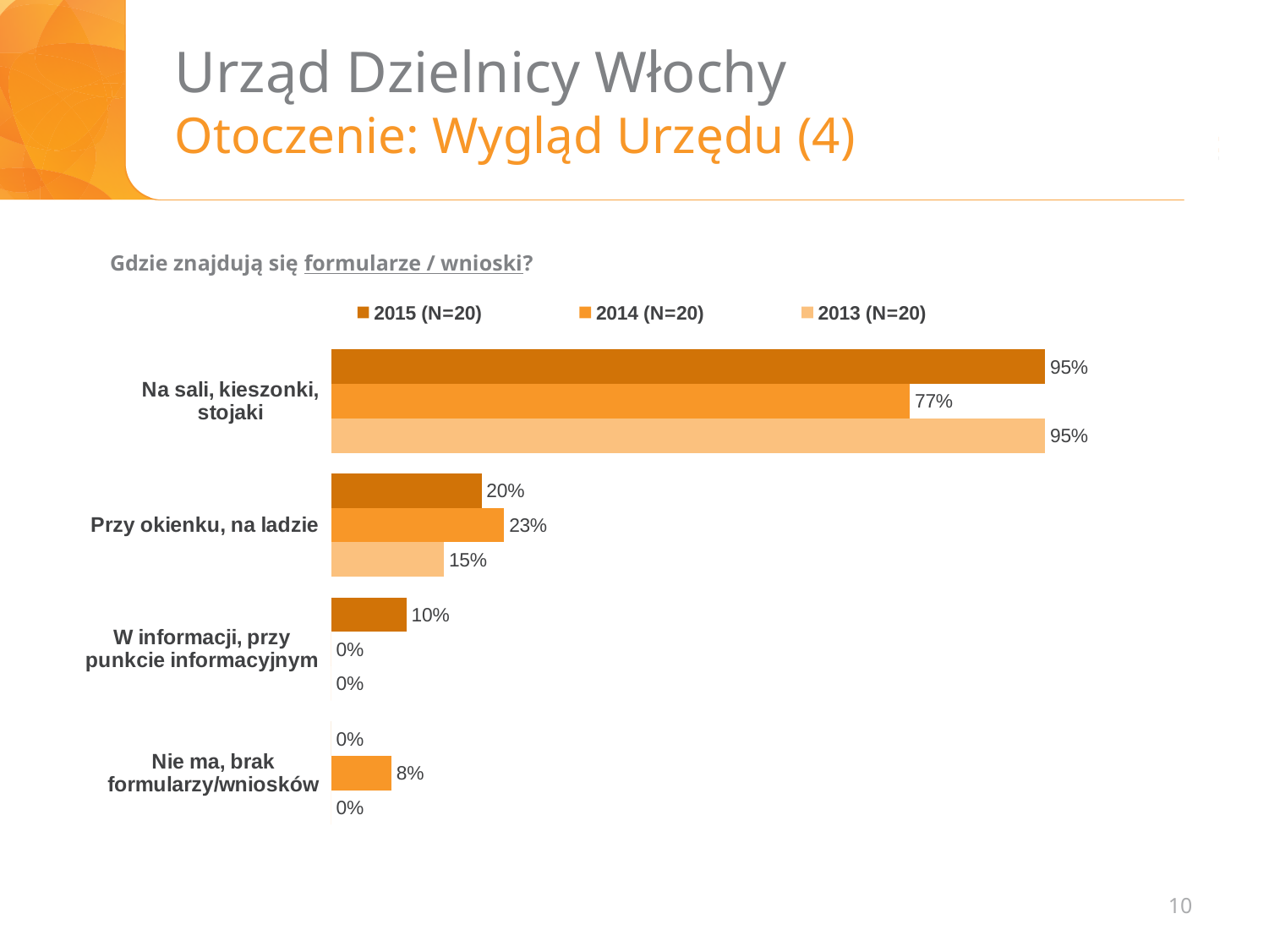
What is the value for "W informacji, przy punkcie informacyjnym" in the 2015 (N=20) series? 10% What is the value for "Nie ma, brak formularzy/wniosków" in the 2014 (N=20) series? 8% What is the value for "Na sali, kieszonki, stojaki" in the 2015 (N=20) series? 95% Which category has the highest value in the 2013 (N=20) series? Na sali, kieszonki, stojaki What question does the chart answer, as stated above it? Gdzie znajdują się formularze / wnioski? How many series does the legend list? 3 How many categories are shown on the chart? 4 What is the difference between the 2015 (N=20) and 2013 (N=20) values for "Przy okienku, na ladzie"? 5% What is the difference between the 2015 (N=20) and 2014 (N=20) values for "Na sali, kieszonki, stojaki"? 18% Which is larger for "Przy okienku, na ladzie": the 2014 (N=20) value or the 2013 (N=20) value? 2014 (N=20) What kind of chart is shown on the slide? Bar chart What is the value for "Przy okienku, na ladzie" in the 2014 (N=20) series? 23%